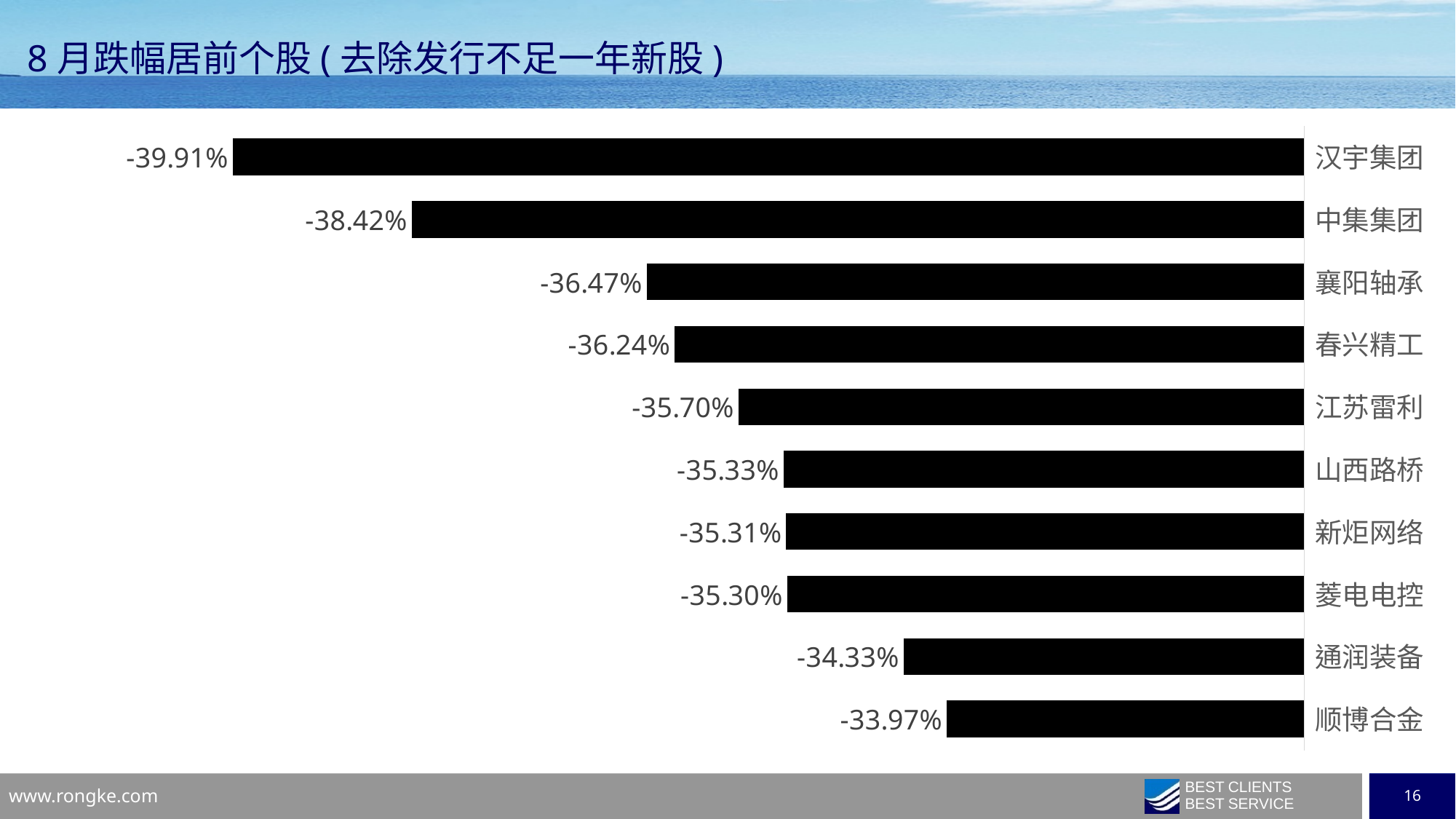
What kind of chart is shown on the slide? Bar chart Which stock fell more in August, 襄阳轴承 or 山西路桥? 襄阳轴承 What is the title of the slide? 8月跌幅居前个股(去除发行不足一年新股) What is the difference in percentage points between the values for 汉宇集团 and 中集集团? 1.49 percentage points Which stock has the smallest decline (the highest value) on the chart? 顺博合金 Which stock has the largest decline (the lowest value) on the chart? 汉宇集团 How many stocks are shown on the chart? 10 What is the difference in percentage points between the values for 通润装备 and 顺博合金? 0.36 percentage points What is the value shown for 江苏雷利? -35.70% What is the value shown for 通润装备? -34.33% What is the value shown for 汉宇集团? -39.91% What is the value shown for 顺博合金? -33.97%